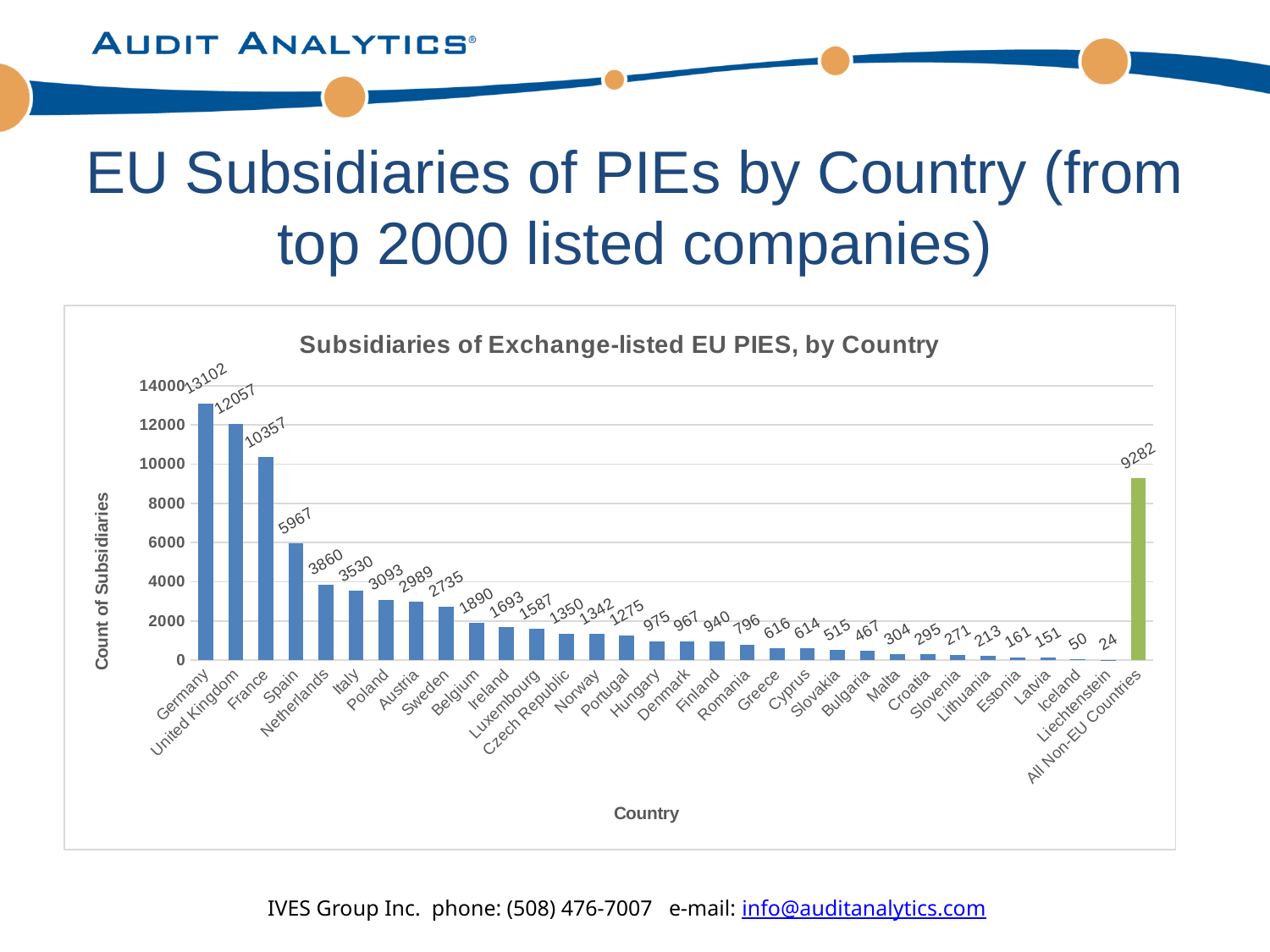
Is the value for France greater or less than 10000? greater What is the title of the chart? Subsidiaries of Exchange-listed EU PIES, by Country Which has a larger count of subsidiaries, Spain or All Non-EU Countries? All Non-EU Countries Do the values for the EU countries rise or fall from Germany to Liechtenstein along the x axis? Fall What is the count of subsidiaries for Germany? 13102 What kind of chart is shown on the slide? Bar chart How many categories are shown on the x axis? 32 What is the count of subsidiaries for All Non-EU Countries? 9282 Which category has the lowest count of subsidiaries? Liechtenstein Which country has the highest count of subsidiaries? Germany What is the count of subsidiaries for Poland? 3093 What is the difference between the counts for Germany and the United Kingdom? 1045